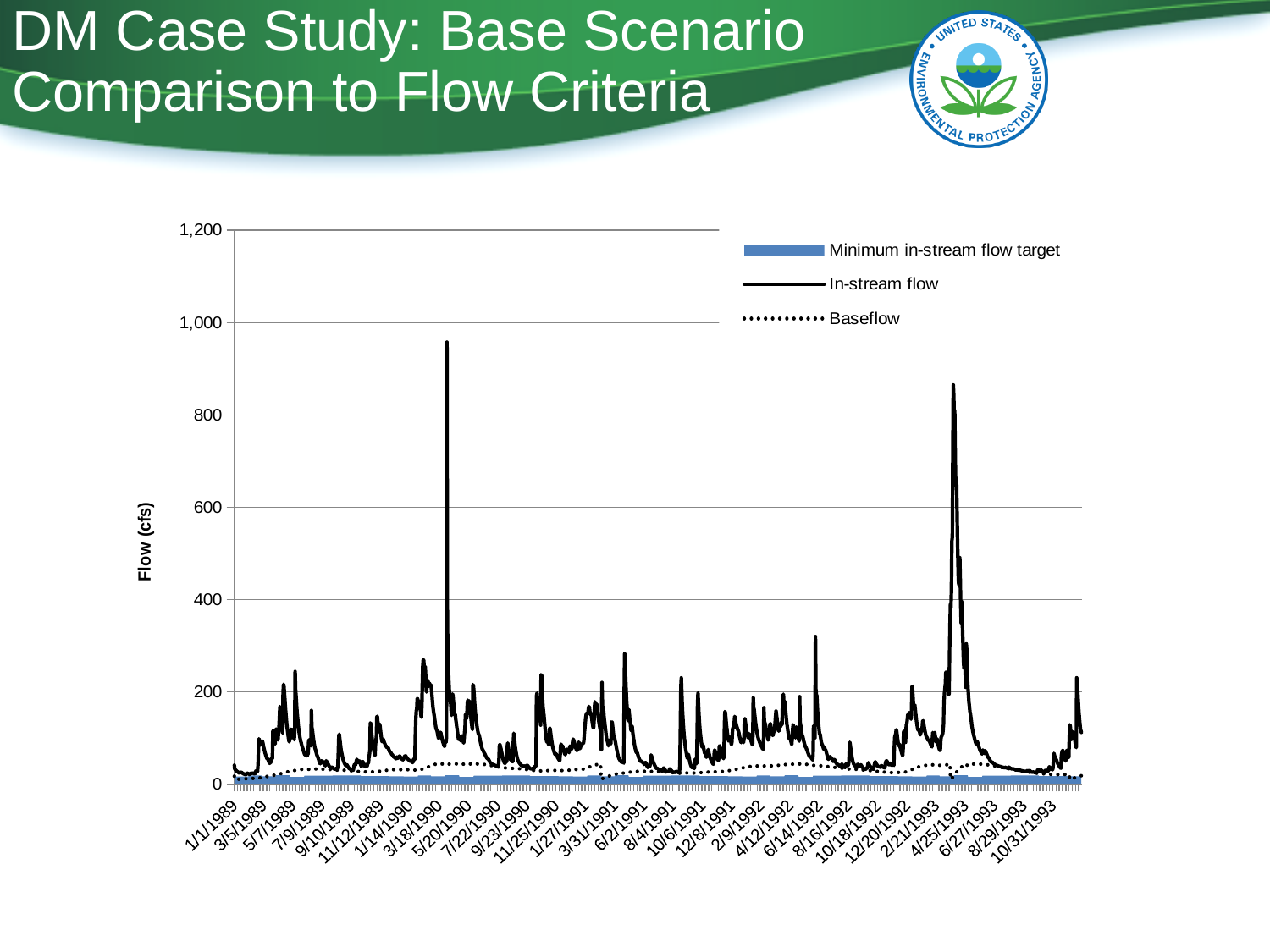
Which series is drawn with a dotted line according to the legend? Baseflow How many series does the legend list? 3 Is the Baseflow series ever greater or less than 200 across the whole period? less What kind of chart is shown on the slide? Line chart What is the highest value shown on the vertical axis? 1,200 Is the highest peak of the In-stream flow series (near 3/18/1990) greater or less than 800? greater What is the title of the vertical axis? Flow (cfs) Is the In-stream flow peak near 4/25/1993 greater or less than 600? greater Which is generally larger over the period, In-stream flow or Baseflow? In-stream flow Which series reaches the highest value on the chart? In-stream flow